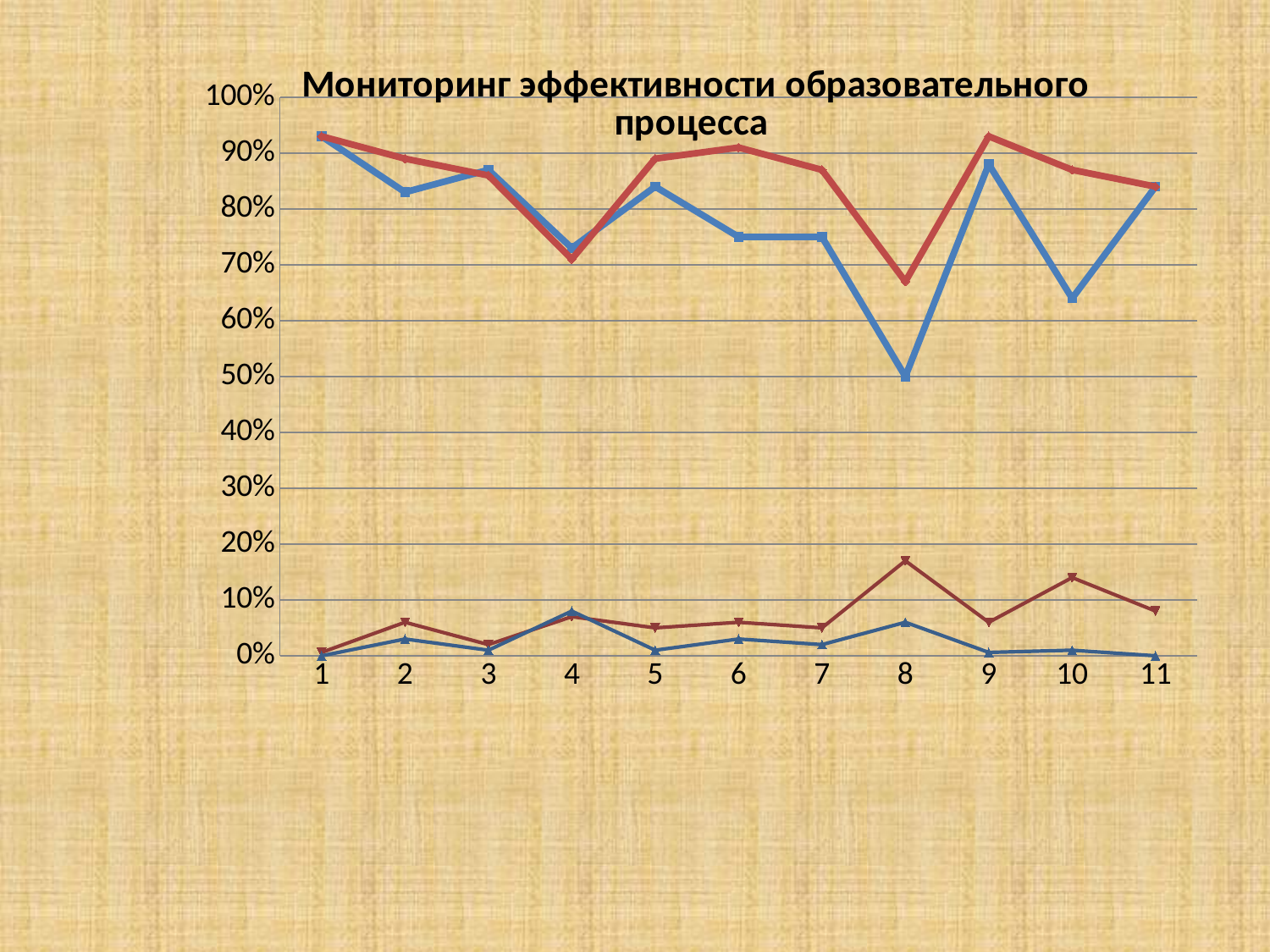
At point 8, which is higher: the thick red line or the thick blue line? the thick red line What is the title of the chart? Мониторинг эффективности образовательного процесса Does the thick blue line rise or fall from point 7 to point 8? fall How many lines are plotted on the chart? 4 At which x-axis point does the thick blue line reach its highest value? 1 Is the value of the thick blue line at point 4 greater or less than 80%? less At which x-axis point does the thick blue line reach its lowest value? 8 What kind of chart is shown on the slide? line chart Is the value of the thick red line at point 8 greater or less than 60%? greater How many points are labelled along the x axis of the chart? 11 Is the value of the thick blue line at point 10 greater or less than 70%? less